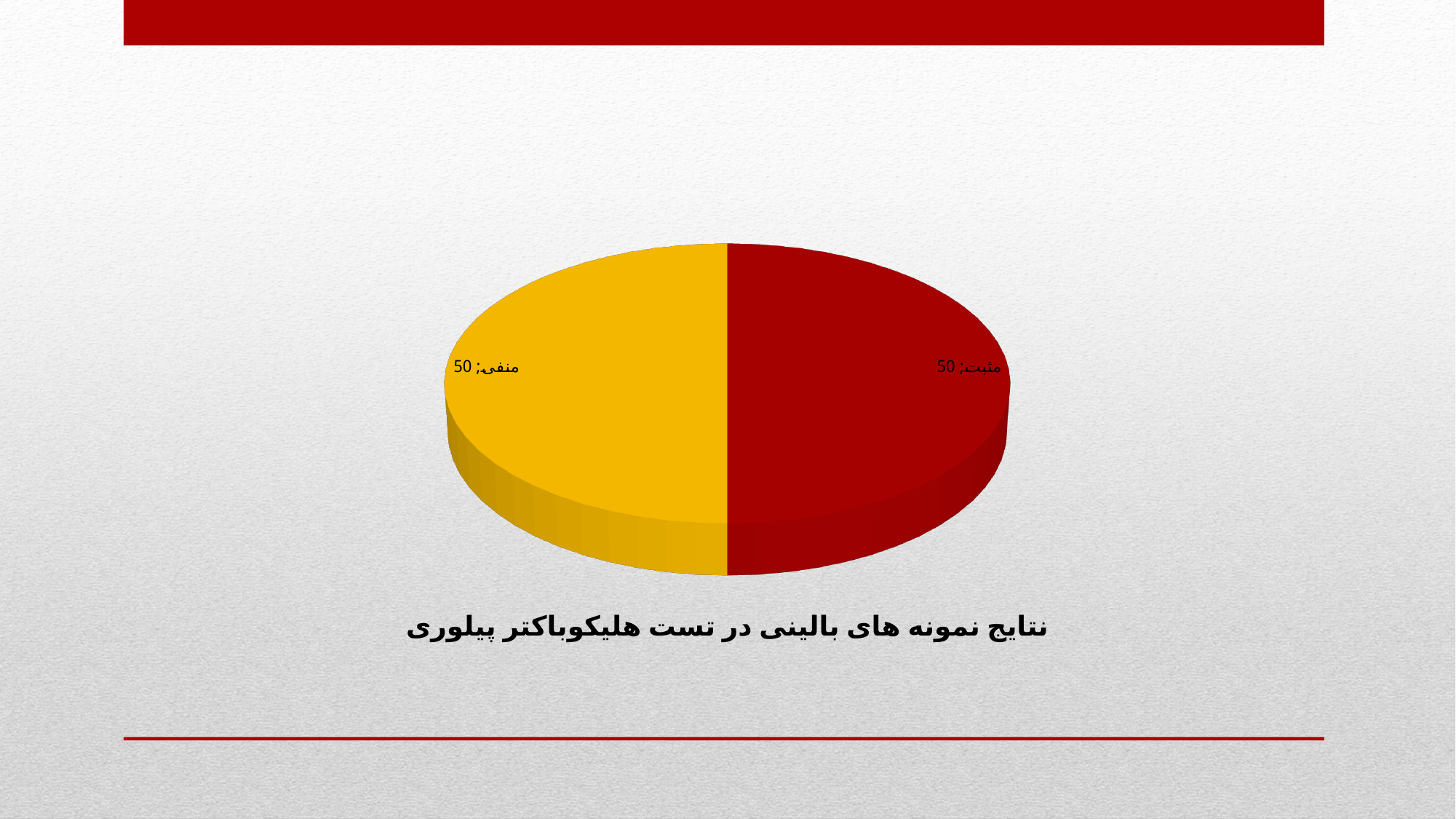
Is the value for مثبت (positive) greater than, less than, or equal to the value for منفی (negative)? equal What share of the pie does the منفی (negative) slice represent? 50% What is the difference between the مثبت (positive) and منفی (negative) values? 0 What is the value of the مثبت (positive) slice? 50 What is the title shown below the pie chart? نتایج نمونه های بالینی در تست هلیکوباکتر پیلوری What type of chart is shown on the slide? Pie chart What is the value of the منفی (negative) slice? 50 What colour is the مثبت (positive) slice? Red What is the total of the two slices in the pie chart? 100 What share of the pie does the مثبت (positive) slice represent? 50% How many slices does the pie chart have? 2